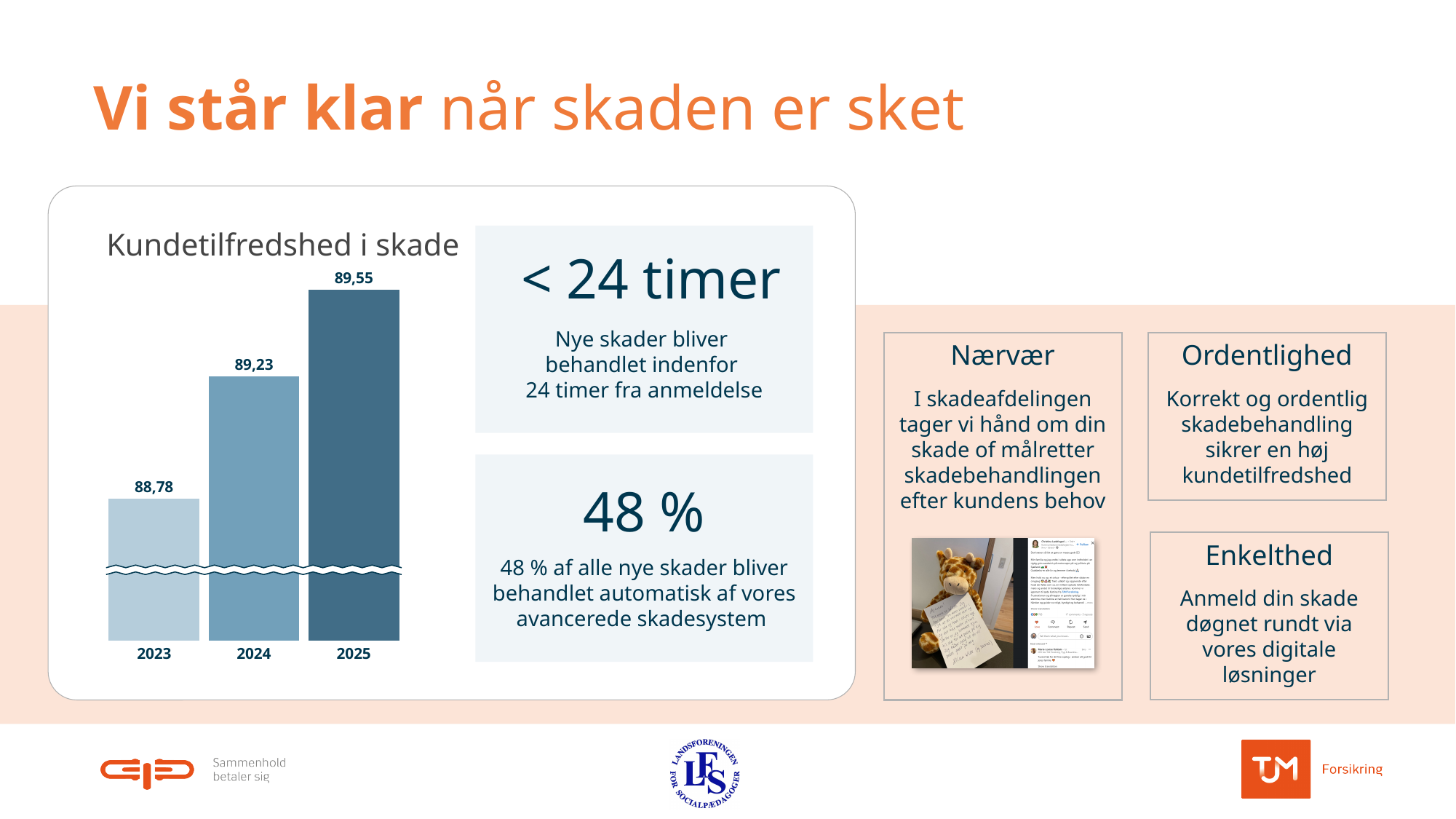
What is the difference between the 2024 and 2023 values in the Kundetilfredshed i skade chart? 0,45 Which year has the highest value in the Kundetilfredshed i skade chart? 2025 What is the value for 2025 in the Kundetilfredshed i skade chart? 89,55 What is the value for 2024 in the Kundetilfredshed i skade chart? 89,23 Do the values in the Kundetilfredshed i skade chart rise or fall from 2023 to 2025? rise Which year has the lowest value in the Kundetilfredshed i skade chart? 2023 How many years are shown in the Kundetilfredshed i skade chart? 3 Which is larger in the Kundetilfredshed i skade chart, the value for 2024 or the value for 2025? 2025 What is the value for 2023 in the Kundetilfredshed i skade chart? 88,78 What is the difference between the 2025 and 2023 values in the Kundetilfredshed i skade chart? 0,77 What is the title of the chart on the slide? Kundetilfredshed i skade What kind of chart is the Kundetilfredshed i skade chart? bar chart